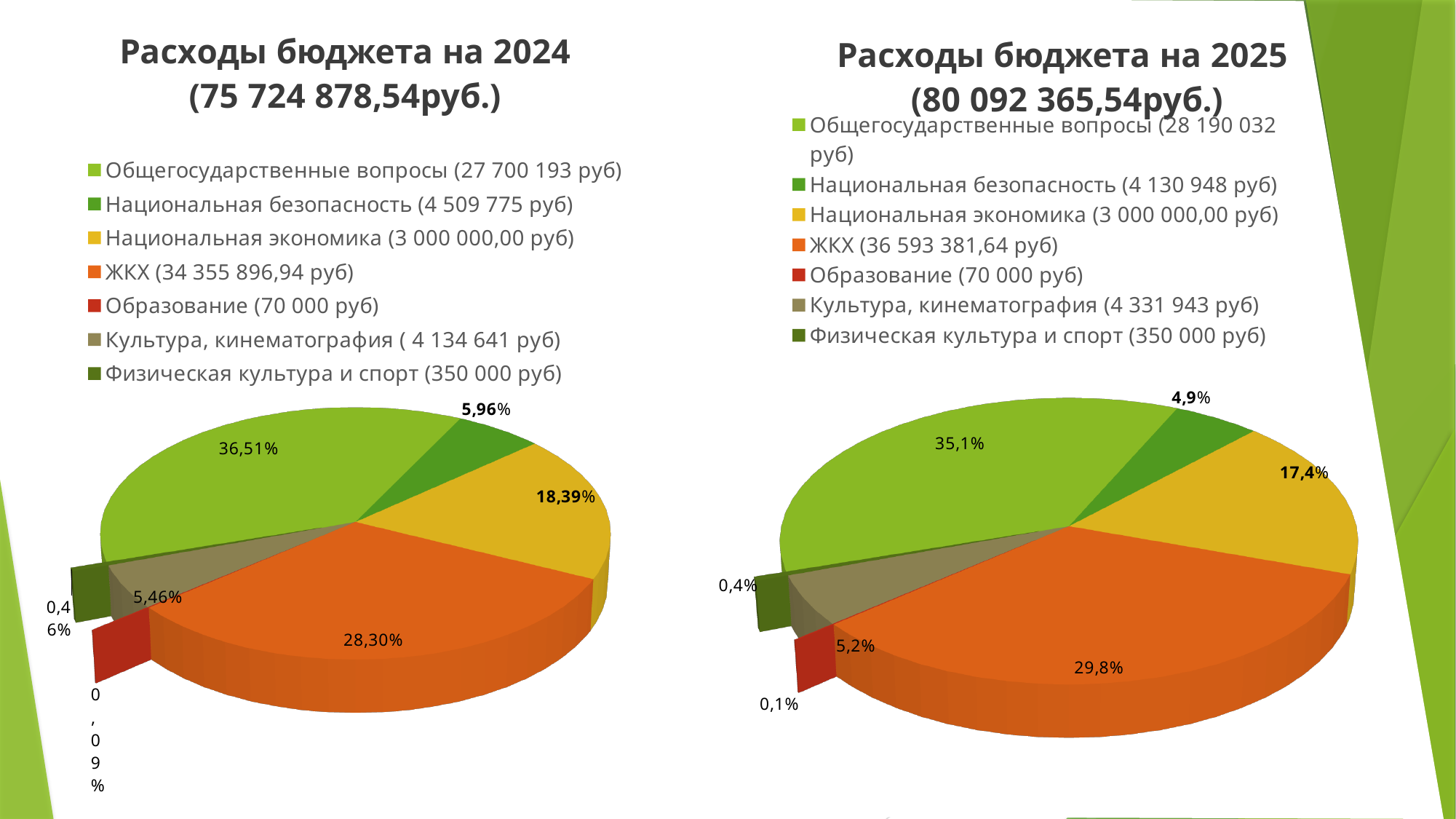
In the 'Расходы бюджета на 2025' chart, what percentage is labelled on the 'Национальная безопасность' slice? 4,9% In the 'Расходы бюджета на 2025' chart, which category has the smallest share? Образование In the 'Расходы бюджета на 2024' chart, what percentage is labelled on the 'ЖКХ' slice? 28,30% According to the legend of the 'Расходы бюджета на 2025' chart, what amount is given for 'Культура, кинематография'? 4 331 943 руб In the 'Расходы бюджета на 2025' chart, what percentage is labelled on the 'Национальная экономика' slice? 17,4% What kind of chart is used for 'Расходы бюджета на 2024'? pie chart In the 'Расходы бюджета на 2024' chart, what percentage is labelled on the 'Общегосударственные вопросы' slice? 36,51% How many categories does the legend of the 'Расходы бюджета на 2025' chart list? 7 Which is larger: the 'ЖКХ' amount in the 2024 chart legend or in the 2025 chart legend? 2025 According to the legend of the 'Расходы бюджета на 2024' chart, what amount is given for 'ЖКХ'? 34 355 896,94 руб What is the difference between the 'Общегосударственные вопросы' amounts in the 2025 and 2024 chart legends? 489 839 руб What total budget amount is shown in the title of the 'Расходы бюджета на 2025' chart? 80 092 365,54руб.